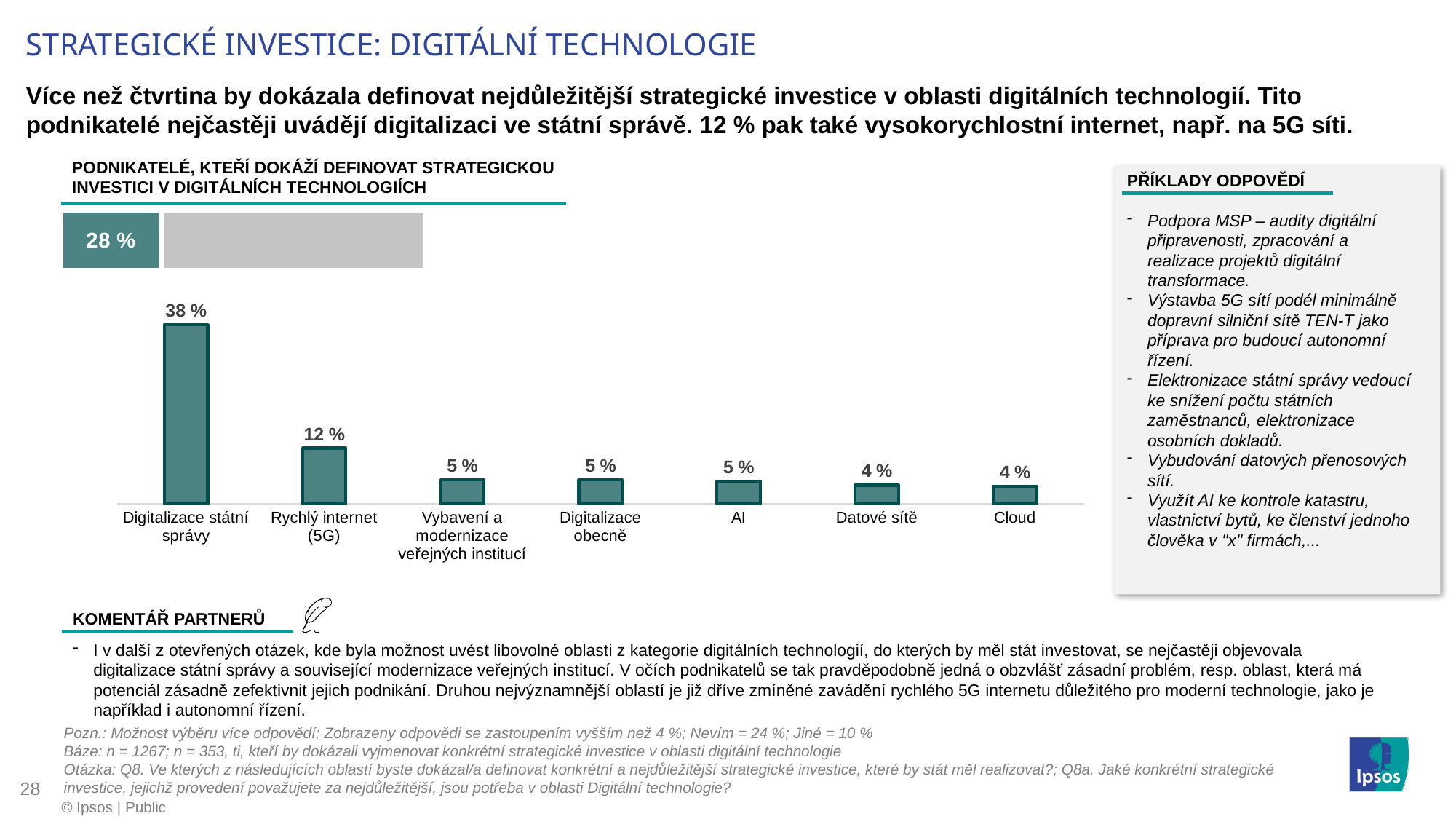
How many categories are shown in the bar chart? 7 In the bar chart, what is the value for Digitalizace státní správy? 38 % In the bar chart, what is the value for Cloud? 4 % What share of respondents is shown in the horizontal bar above the bar chart (those who can define a strategic investment in digital technologies)? 28 % In the bar chart, which is larger: Rychlý internet (5G) or Digitalizace obecně? Rychlý internet (5G) Do the values in the bar chart rise or fall from left to right? Fall In the bar chart, what is the difference between Digitalizace státní správy and Rychlý internet (5G)? 26 % In the bar chart, what is the value for AI? 5 % In the bar chart, which category has the highest value? Digitalizace státní správy What kind of chart is used to show the categories from Digitalizace státní správy to Cloud? Bar chart In the bar chart, what is the value for Datové sítě? 4 % In the bar chart, what is the value for Rychlý internet (5G)? 12 %